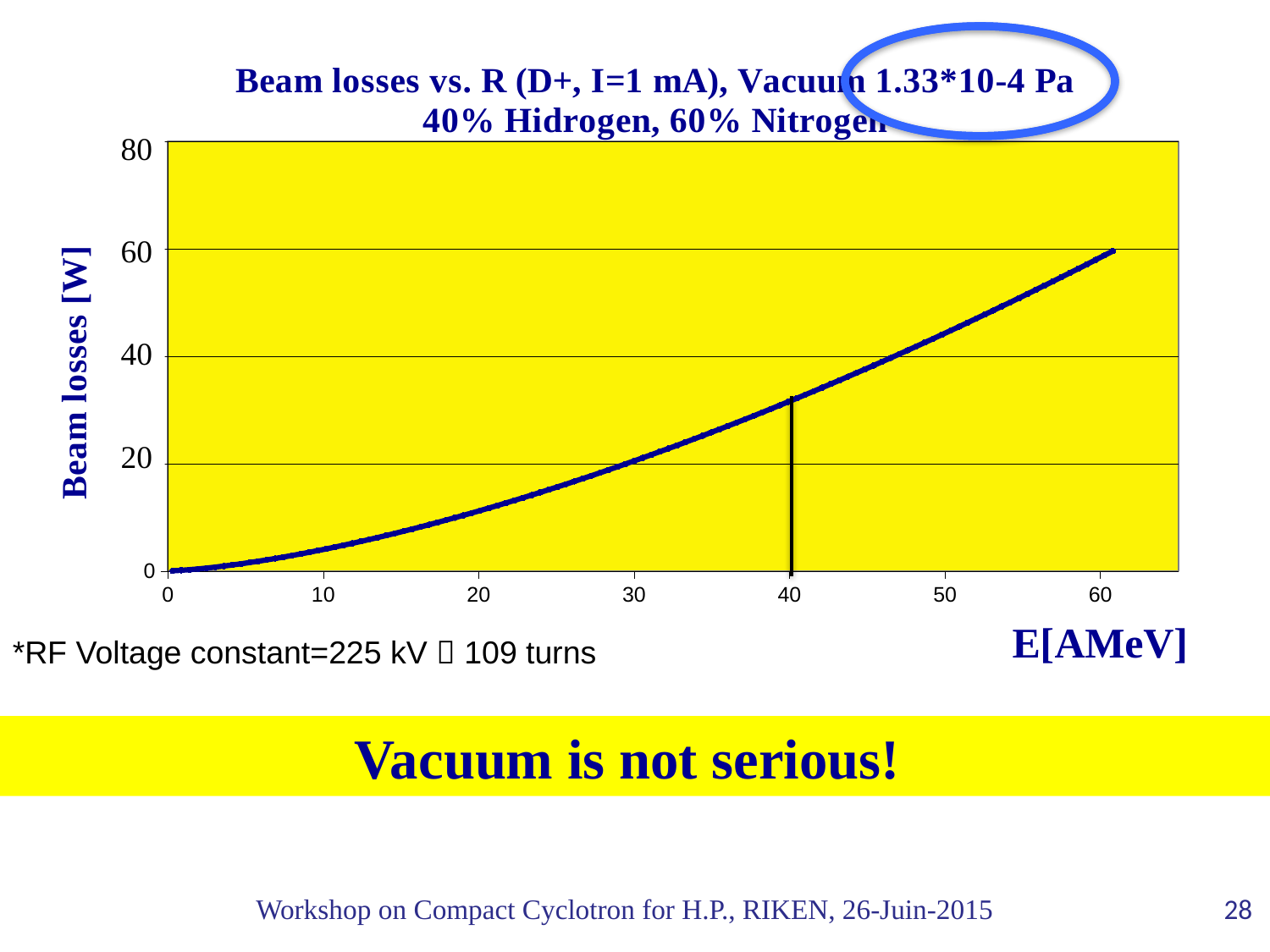
Is the beam loss value at E = 50 AMeV greater or less than 60 W? less Is the beam loss value at E = 60 AMeV greater or less than 40 W? greater Is the beam loss value at E = 40 AMeV greater or less than 40 W? less What is the label of the x axis of the chart? E[AMeV] Do the beam losses rise or fall as E[AMeV] increases along the x axis? rise Which is larger, the beam loss at E = 20 AMeV or at E = 50 AMeV? E = 50 AMeV What is the highest value shown on the y axis of the chart? 80 What is the label of the y axis of the chart? Beam losses [W] What kind of chart is shown on the slide? line chart